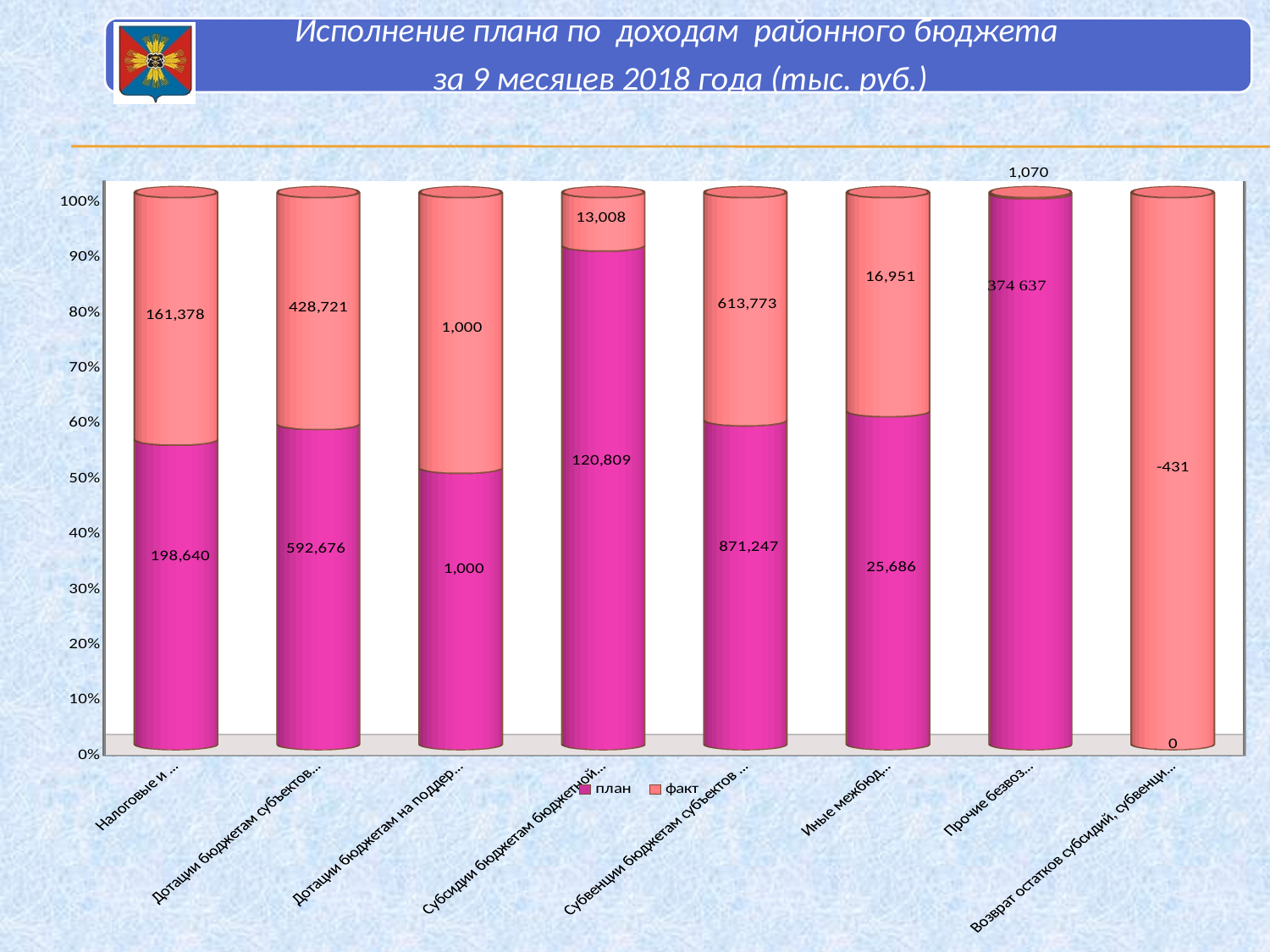
How many series does the legend list? 2 What is the план value for the category 'Прочие безвоз...'? 374 637 For the category 'Иные межбюд...', which is larger, план or факт? план What is the difference between the план and факт values for 'Налоговые и ...'? 37,262 What are the two legend entries of the chart? план and факт What kind of chart is shown on the slide? Stacked bar chart How many categories (bars) are shown on the chart? 8 Which category has the highest план value? Субвенции бюджетам субъектов ... What is the факт value for the category 'Дотации бюджетам субъектов...'? 428,721 What is the факт value for the category 'Субсидии бюджетам бюджетной...'? 13,008 What is the план value for the first category, 'Налоговые и ...'? 198,640 What is the факт value for the last category, 'Возврат остатков субсидий, субвенци...'? -431